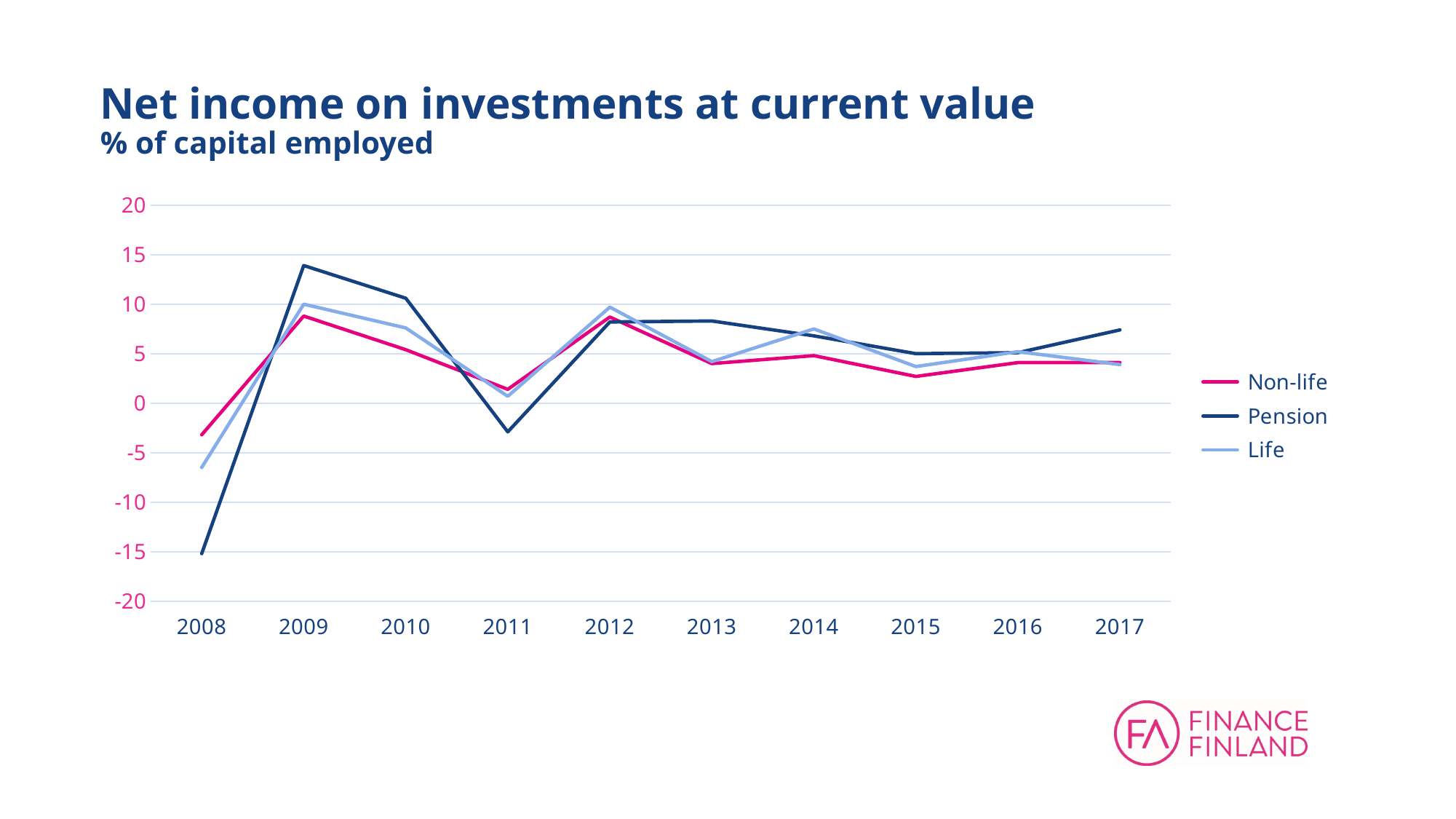
How many series does the legend list? 3 What is the title of the chart? Net income on investments at current value Does the Pension series rise or fall from 2009 to 2011? fall In 2008, which series has the larger value, Non-life or Pension? Non-life In which year does the Pension series reach its lowest value? 2008 Is the value for Pension in 2009 greater or less than 10? greater In which year does the Pension series reach its highest value? 2009 How many years are shown on the x axis? 10 Is the value for Non-life in 2011 greater or less than 0? greater Is the value for Pension in 2008 greater or less than -10? less What kind of chart is shown on the slide? Line chart In 2011, which series has the larger value, Pension or Life? Life